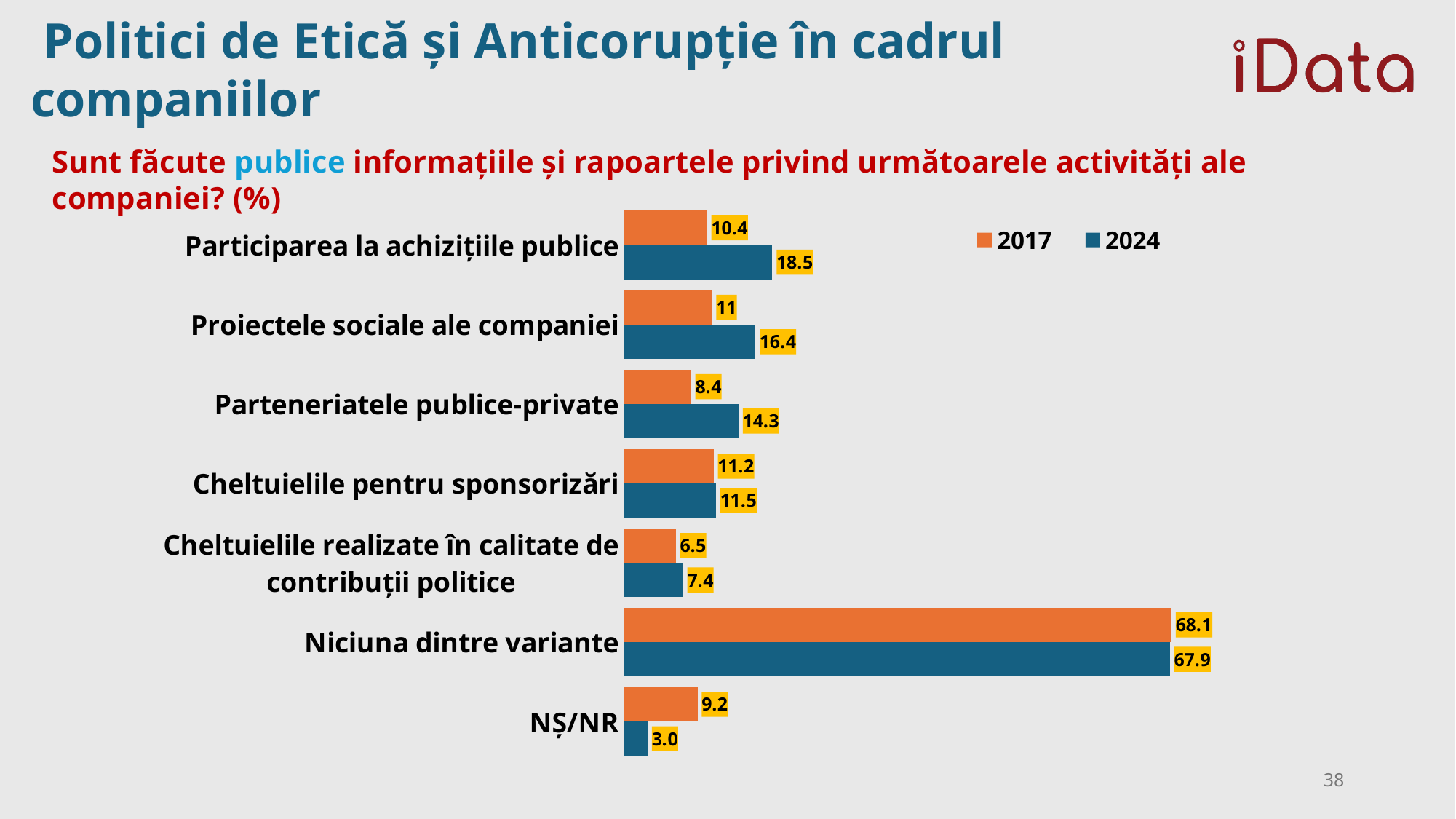
How many categories are shown in the chart? 7 What is the 2024 value for Participarea la achizițiile publice? 18.5 What is the 2024 value for NȘ/NR? 3.0 What is the 2017 value for Proiectele sociale ale companiei? 11 What kind of chart is shown on the slide? Bar chart Which colour represents the 2024 series in the chart? Blue What is the 2017 value for Cheltuielile realizate în calitate de contribuții politice? 6.5 What is the difference between the 2024 and 2017 values for Parteneriatele publice-private? 5.9 Which category has the highest 2017 value? Niciuna dintre variante Which category has the lowest 2024 value? NȘ/NR Which is larger for NȘ/NR, the 2017 value or the 2024 value? 2017 How many series does the legend list? 2